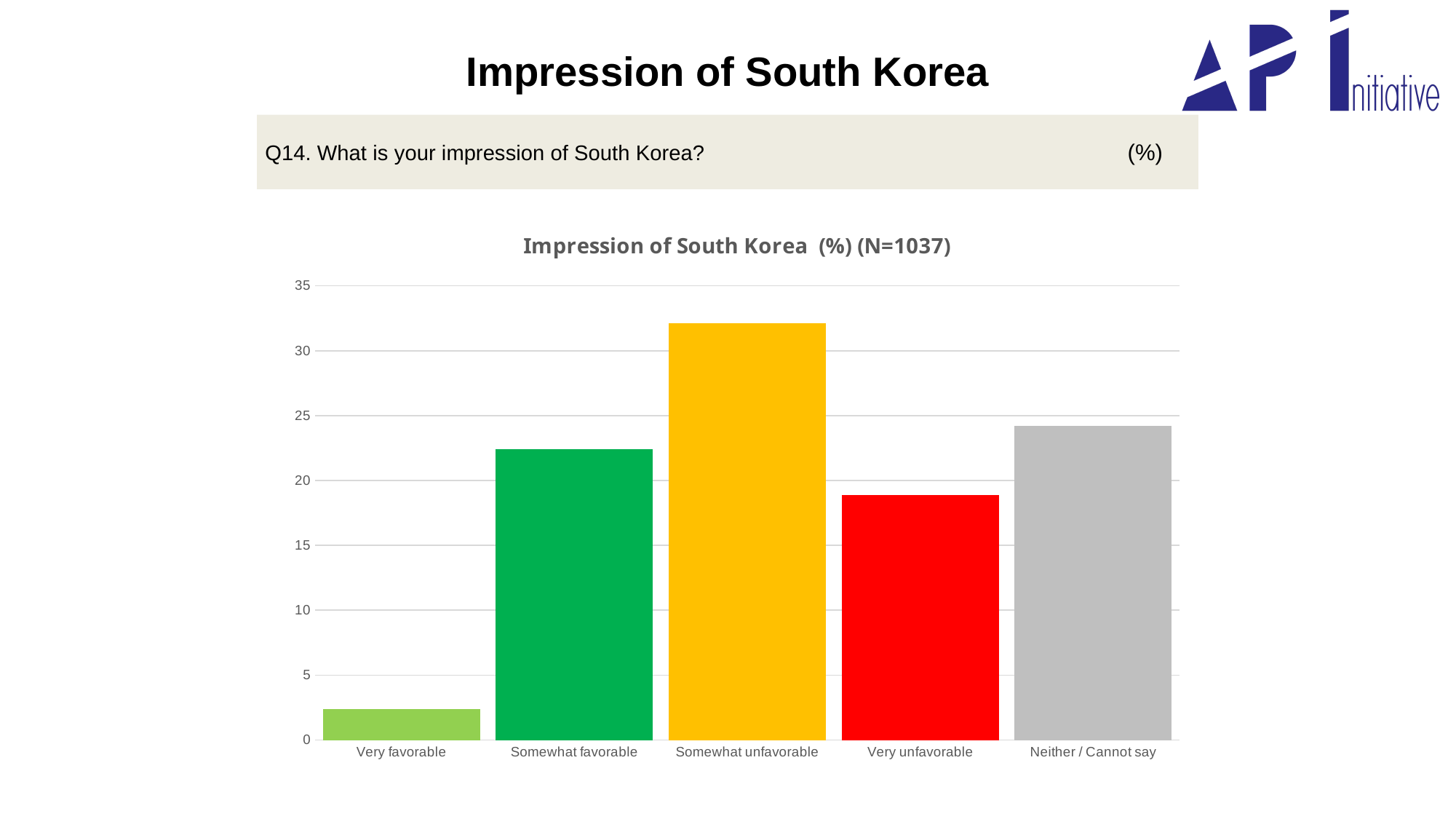
What type of chart is shown on the slide? bar chart Is the value for Neither / Cannot say greater or less than 25? less What is the title of the chart? Impression of South Korea (%) (N=1037) Which category has the highest value in the chart? Somewhat unfavorable Which is larger, the value for Somewhat favorable or the value for Very unfavorable? Somewhat favorable Is the value for Somewhat favorable greater or less than 20? greater What colour is the bar for Very unfavorable? red Is the value for Somewhat unfavorable greater or less than 30? greater How many categories are shown on the x axis of the chart? 5 Which category has the lowest value in the chart? Very favorable